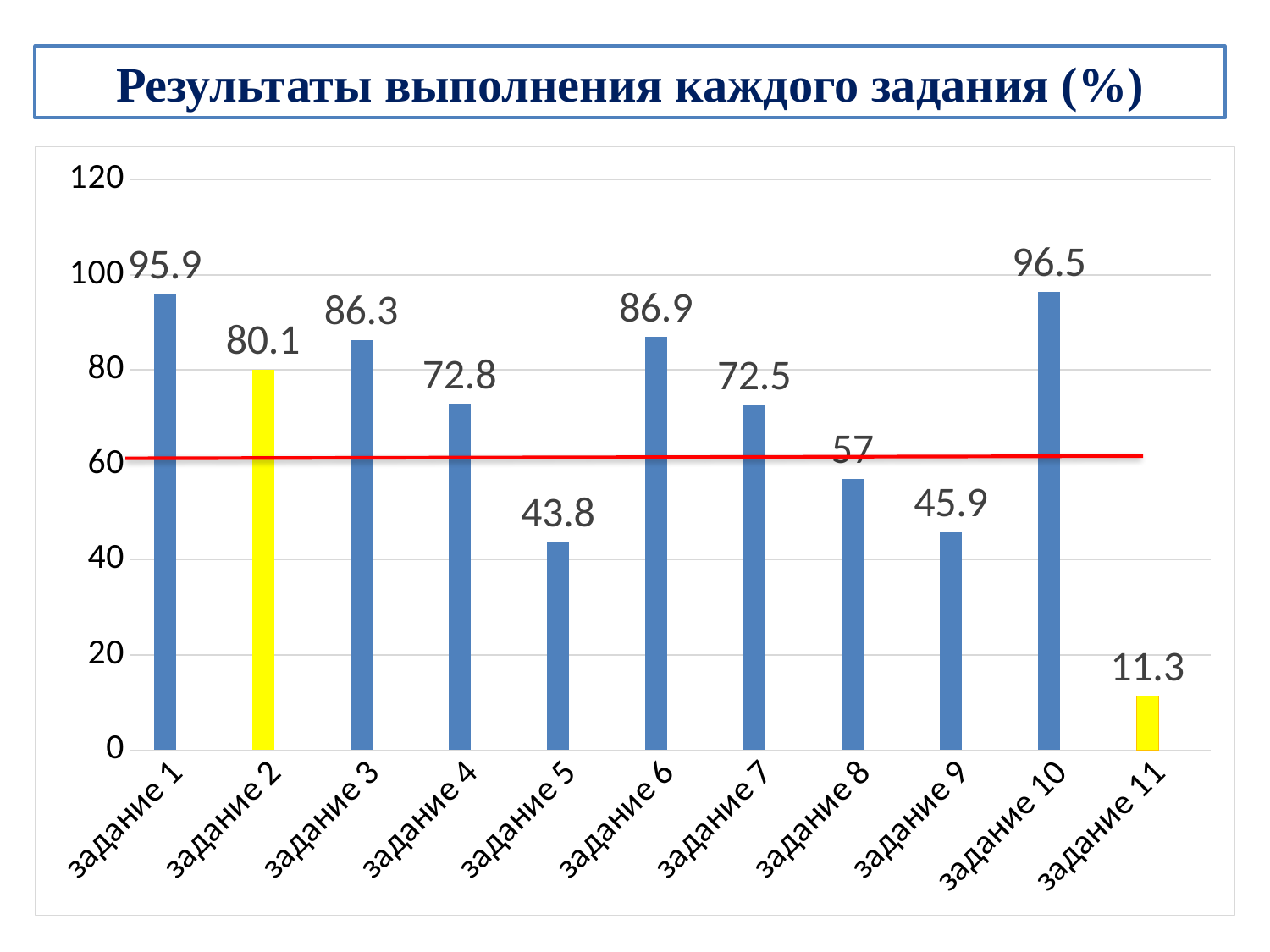
How many categories are shown on the x axis? 11 What is the value for задание 11? 11.3 Which is larger, the value for задание 3 or the value for задание 6? задание 6 Which category has the highest value? задание 10 Which two bars are coloured yellow instead of blue? задание 2 and задание 11 What is the title of the slide? Результаты выполнения каждого задания (%) What kind of chart is shown on the slide? bar chart What is the difference between the values for задание 10 and задание 11? 85.2 Is the value for задание 8 greater or less than 60? less Which category has the lowest value? задание 11 What is the value for задание 5? 43.8 What is the value for задание 1? 95.9